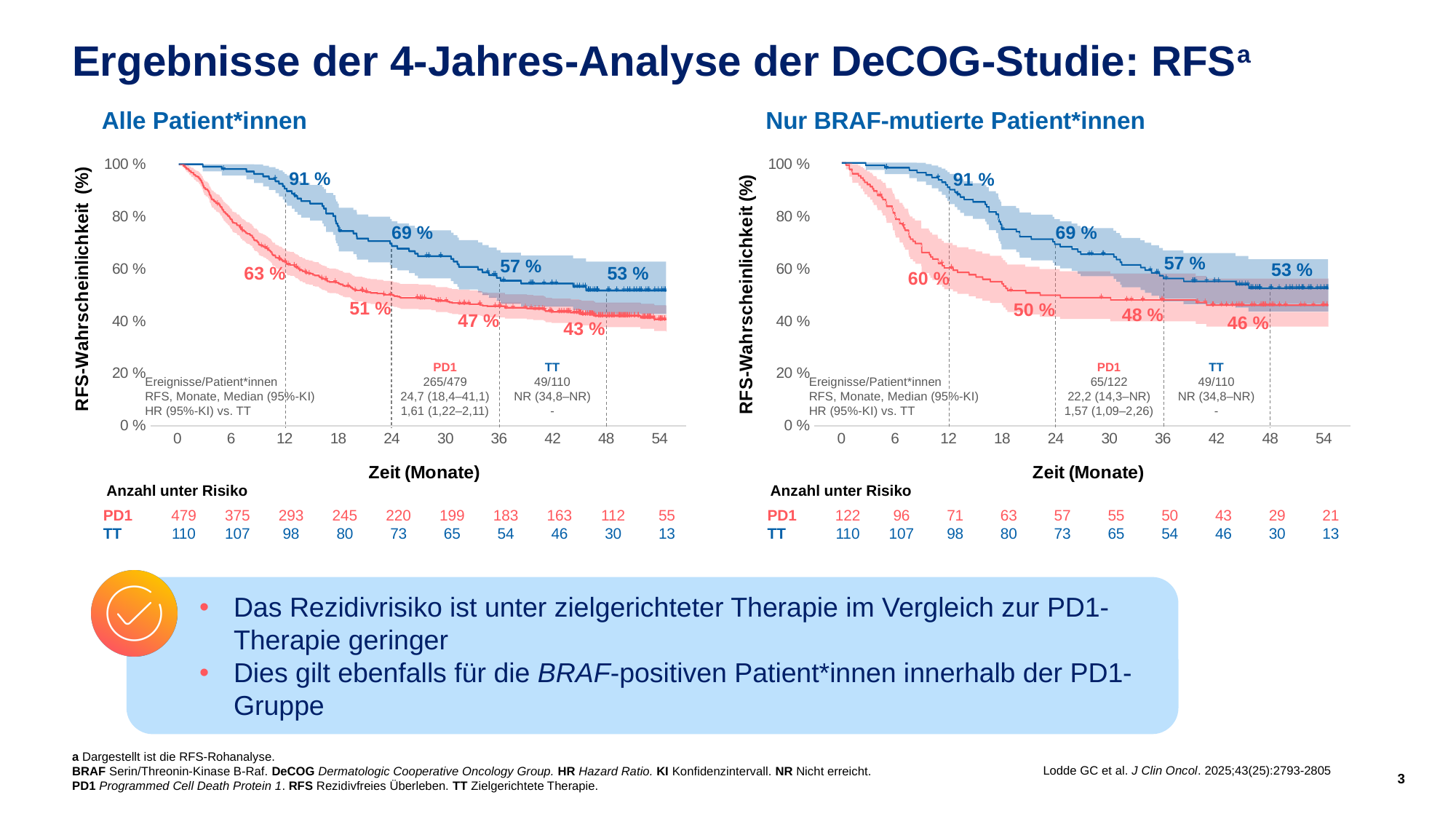
In the chart 'Alle Patient*innen', which group has the higher labelled RFS probability at 36 months, PD1 or TT? TT What kind of chart is shown under 'Alle Patient*innen'? Line chart (Kaplan-Meier survival curve) In the chart 'Nur BRAF-mutierte Patient*innen', what is the difference between the labelled TT and PD1 values at 48 months? 7 percentage points In the chart 'Nur BRAF-mutierte Patient*innen', how many TT patients are at risk at 54 months? 13 In the chart 'Nur BRAF-mutierte Patient*innen', what is the labelled RFS probability for TT at 36 months? 57 % In the chart 'Alle Patient*innen', how many patients in the PD1 group are at risk at 0 months according to the 'Anzahl unter Risiko' table? 479 In the chart 'Alle Patient*innen', what is the labelled RFS probability for TT at 12 months? 91 % In the chart 'Alle Patient*innen', do the RFS curves rise or fall over time? Fall How many groups (series) are plotted in the chart 'Nur BRAF-mutierte Patient*innen'? 2 In the chart 'Alle Patient*innen', what is the labelled RFS probability for PD1 at 48 months? 43 % In the chart 'Alle Patient*innen', what is the difference between the labelled TT and PD1 values at 24 months? 18 percentage points In the chart 'Nur BRAF-mutierte Patient*innen', what is the labelled RFS probability for PD1 at 12 months? 60 %